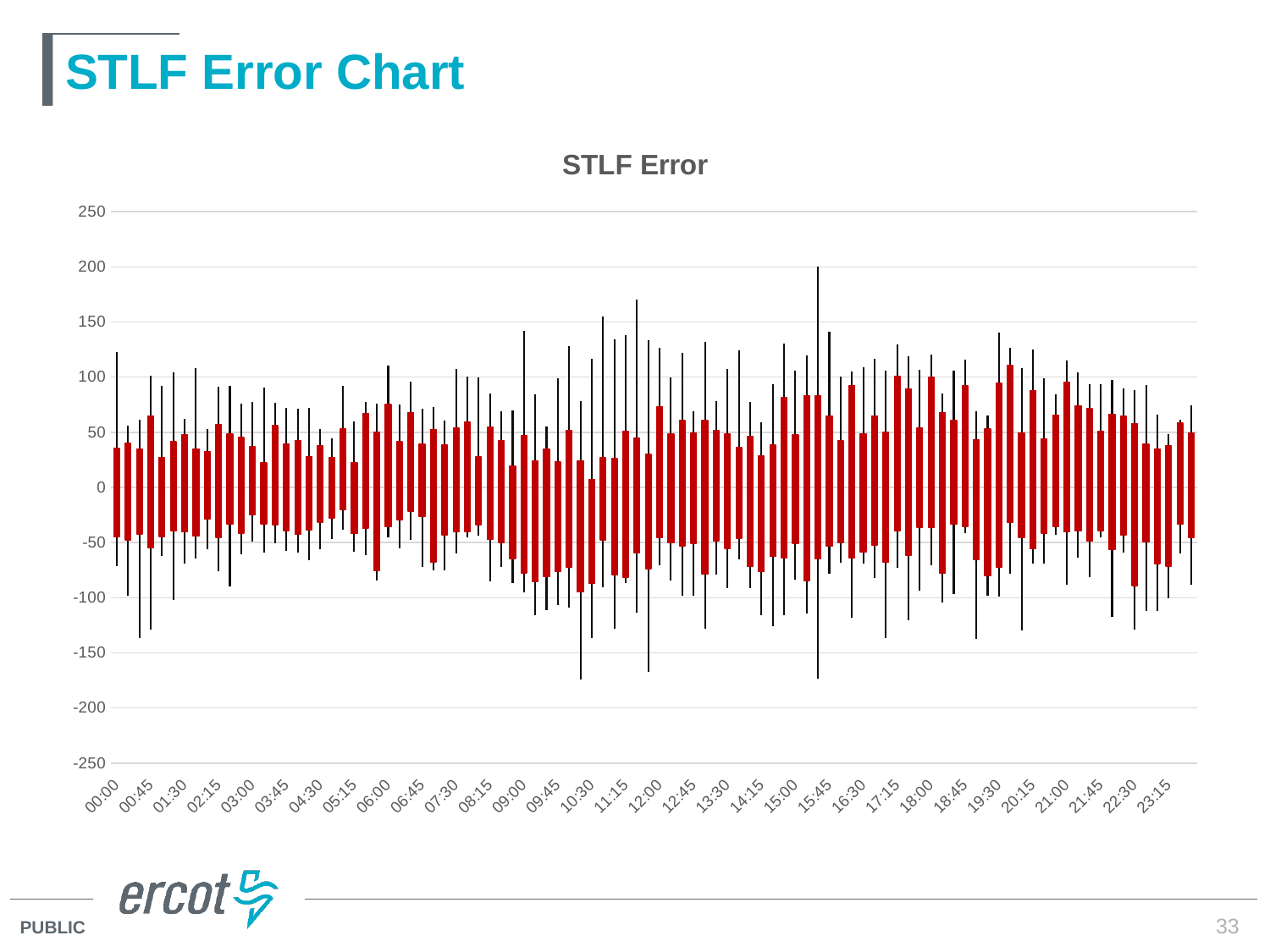
What is the last time label on the horizontal axis? 23:15 Is the highest whisker on the chart (near 15:45) greater or less than 150? greater Does any whisker on the chart extend beyond 250 or below -250? No What kind of chart is shown on the slide? Stock (high-low) chart with red boxes and whiskers What is the minimum value shown on the vertical axis? -250 What colour are the boxes in the chart? Red What is the maximum value shown on the vertical axis? 250 What is the title of the chart? STLF Error What is the first time label on the horizontal axis? 00:00 How many time labels are printed along the horizontal axis? 32